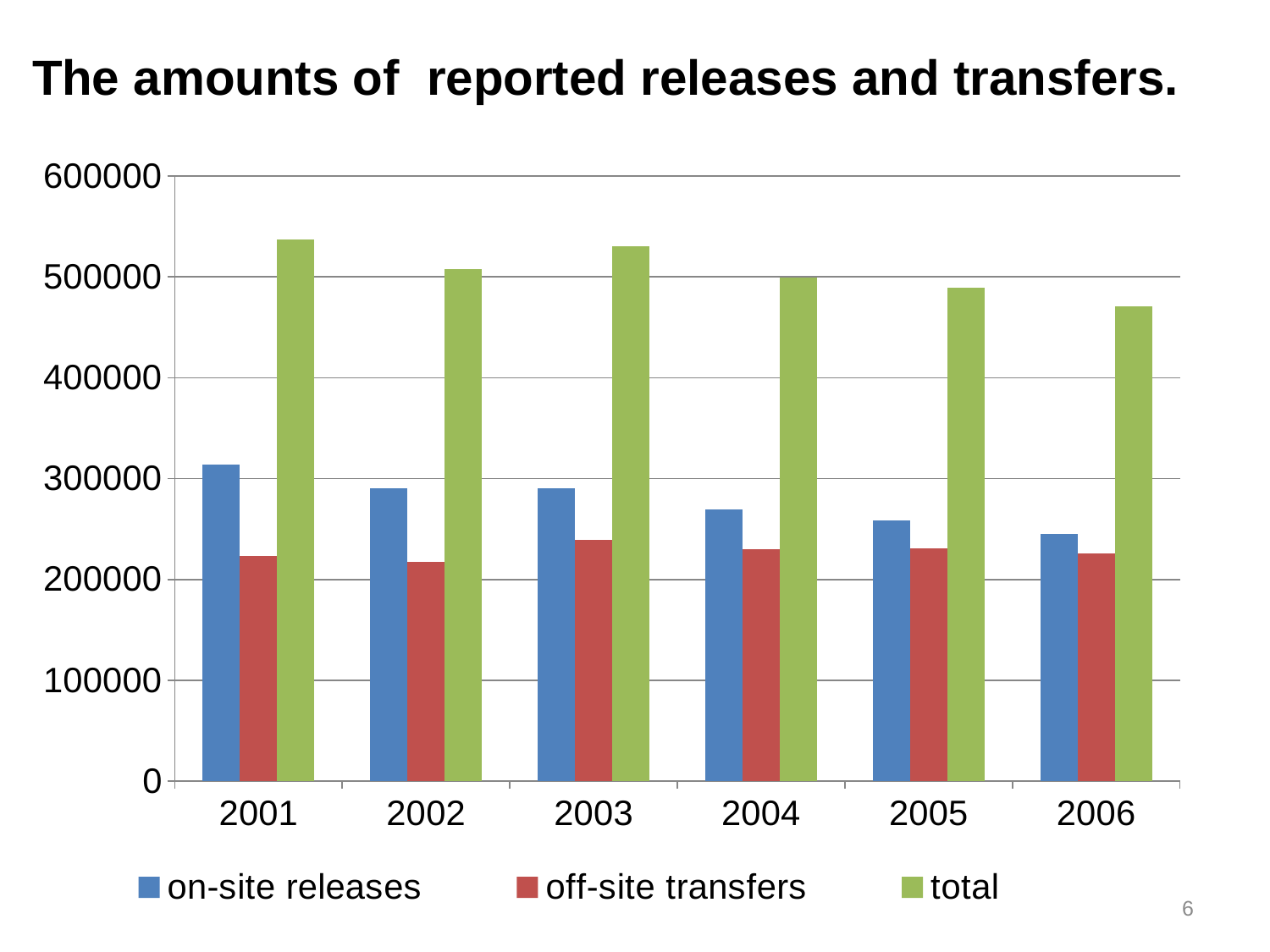
What kind of chart is shown on the slide? bar chart Which is larger in 2001, on-site releases or off-site transfers? on-site releases Do the values for on-site releases rise or fall from 2001 to 2006? fall Which year has the lowest value for on-site releases? 2006 Is the value for total in 2006 greater or less than 500000? less Is the value for off-site transfers in 2003 greater or less than 200000? greater Which year has the lowest value for total? 2006 How many years are shown on the x axis? 6 Which year has the highest value for on-site releases? 2001 Which year has the highest value for off-site transfers? 2003 How many series does the legend list? 3 Is the value for on-site releases in 2001 greater or less than 300000? greater